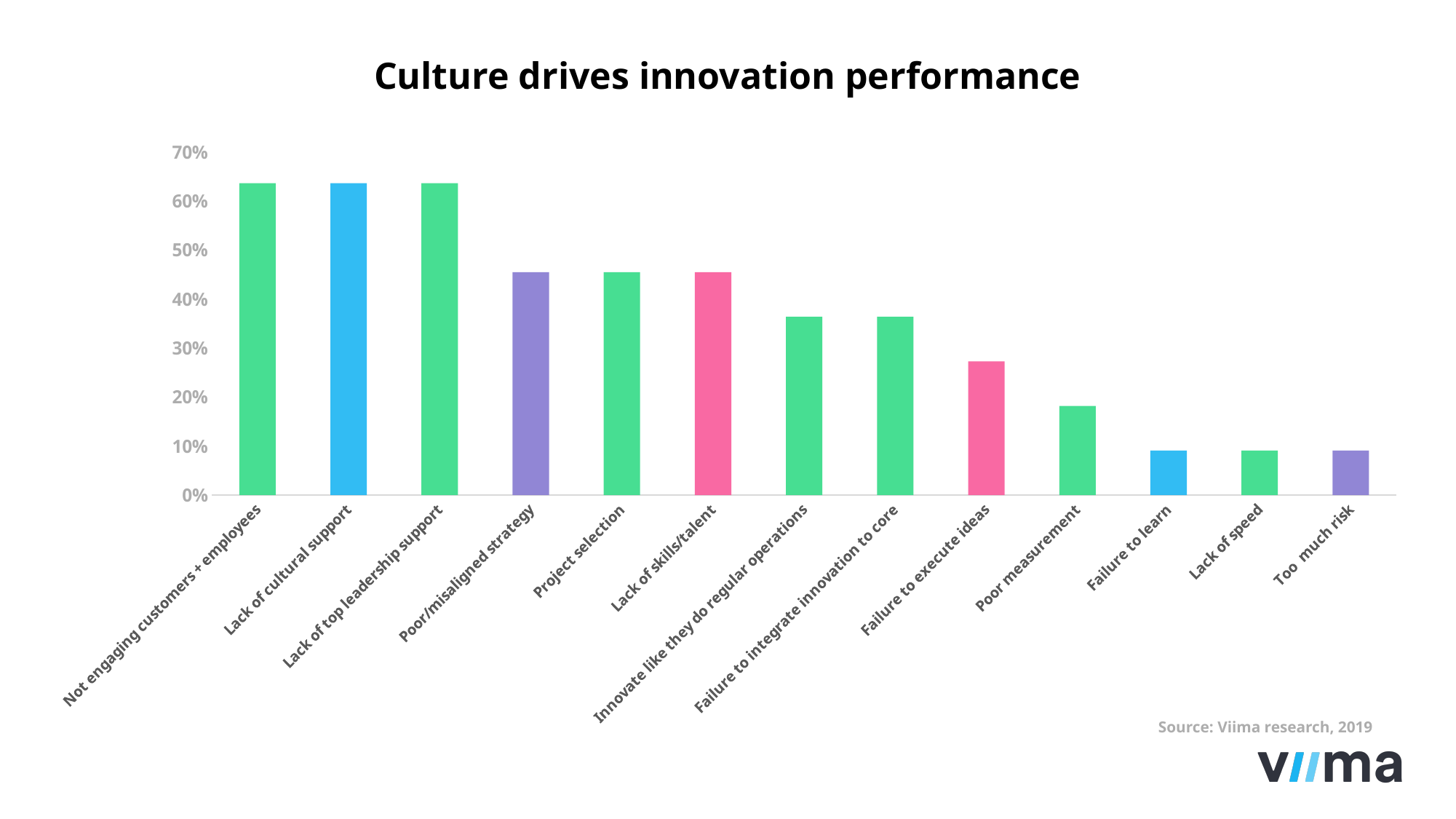
Which has the larger value, "Lack of cultural support" or "Project selection"? Lack of cultural support What kind of chart is shown on the slide? Bar chart What is the title of the chart? Culture drives innovation performance How many categories are plotted on the chart? 13 Is the value for "Lack of skills/talent" greater or less than 40%? greater Is the value for "Poor/misaligned strategy" greater or less than 50%? less What source is cited for the chart data? Viima research, 2019 Is the value for "Failure to execute ideas" greater or less than 20%? greater Do the bar values generally rise or fall from left to right along the x axis? Fall